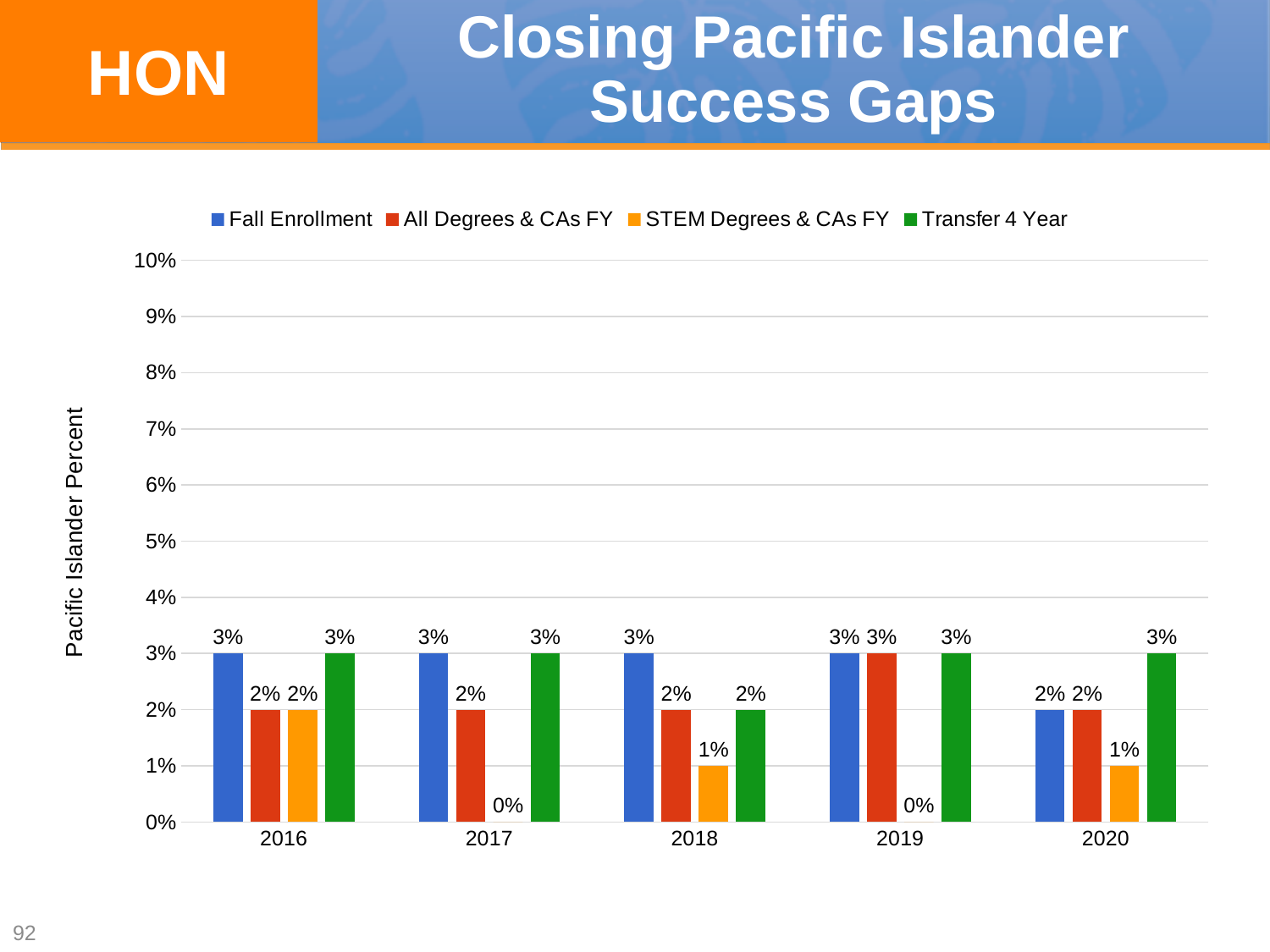
What is the Transfer 4 Year value for 2018? 2% What is the STEM Degrees & CAs FY value for 2017? 0% What is the All Degrees & CAs FY value for 2019? 3% In 2020, which is larger: the Transfer 4 Year value or the STEM Degrees & CAs FY value? Transfer 4 Year What is the Fall Enrollment value for 2020? 2% What is the Fall Enrollment value for 2016? 3% What kind of chart is shown on the slide? Bar chart Which year has the lowest Fall Enrollment value? 2020 How many series does the legend list? 4 How many years are shown on the x axis? 5 What is the label of the y axis? Pacific Islander Percent What is the difference between the Fall Enrollment value and the STEM Degrees & CAs FY value in 2018? 2%